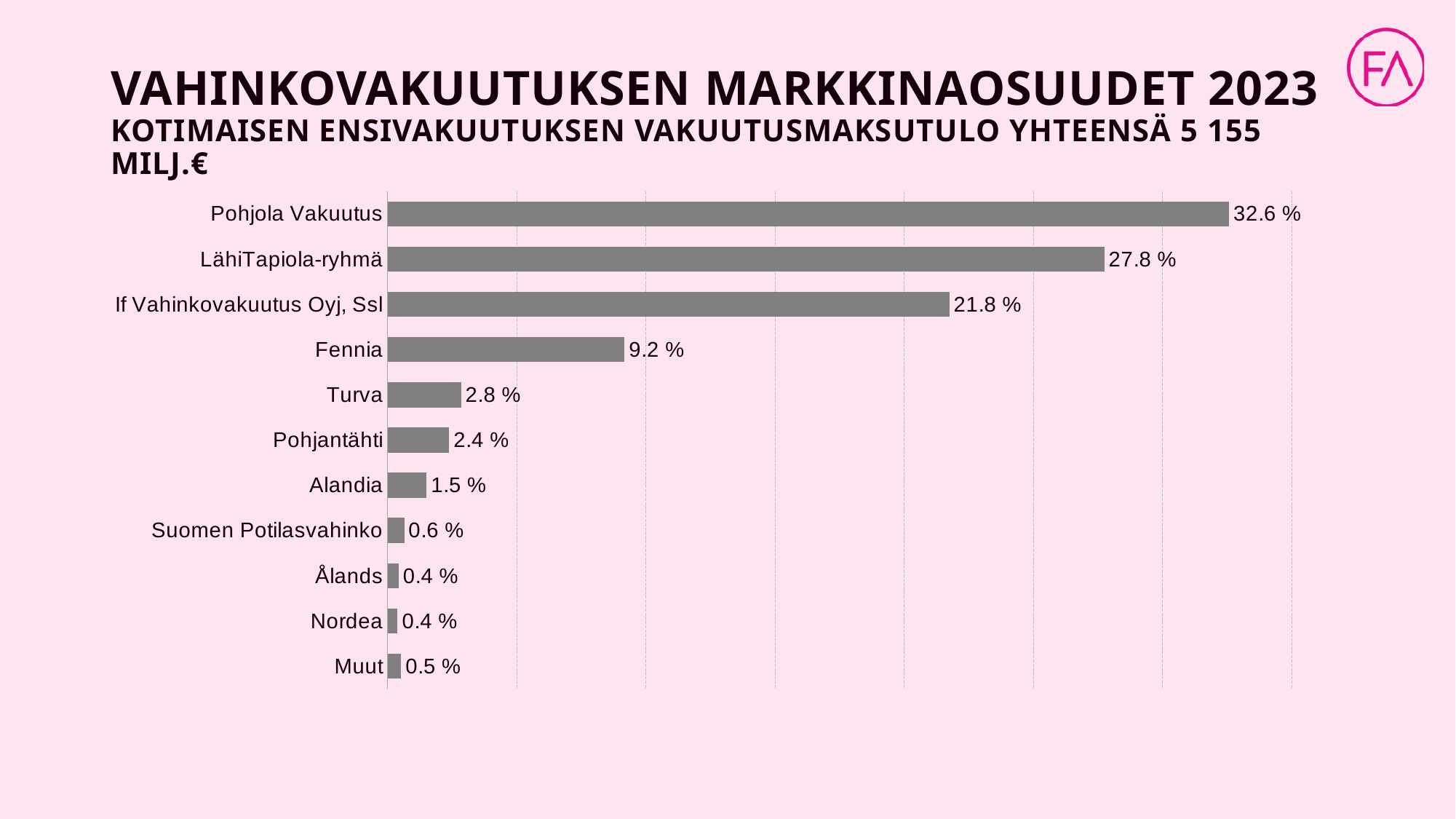
What is the total domestic direct insurance premium income stated in the slide subtitle? 5 155 milj.€ What type of chart is shown on the slide? Bar chart How many companies or categories are shown in the chart? 11 What is the market share shown for Pohjola Vakuutus? 32.6 % What is the market share shown for Suomen Potilasvahinko? 0.6 % What is the difference in market share between Pohjola Vakuutus and LähiTapiola-ryhmä? 4.8 % Which has a larger market share, LähiTapiola-ryhmä or If Vahinkovakuutus Oyj, Ssl? LähiTapiola-ryhmä Which has a larger market share, Turva or Pohjantähti? Turva What is the difference in market share between If Vahinkovakuutus Oyj, Ssl and Fennia? 12.6 % What is the market share shown for Fennia? 9.2 % Which company has the highest market share in the chart? Pohjola Vakuutus What is the market share shown for Alandia? 1.5 %